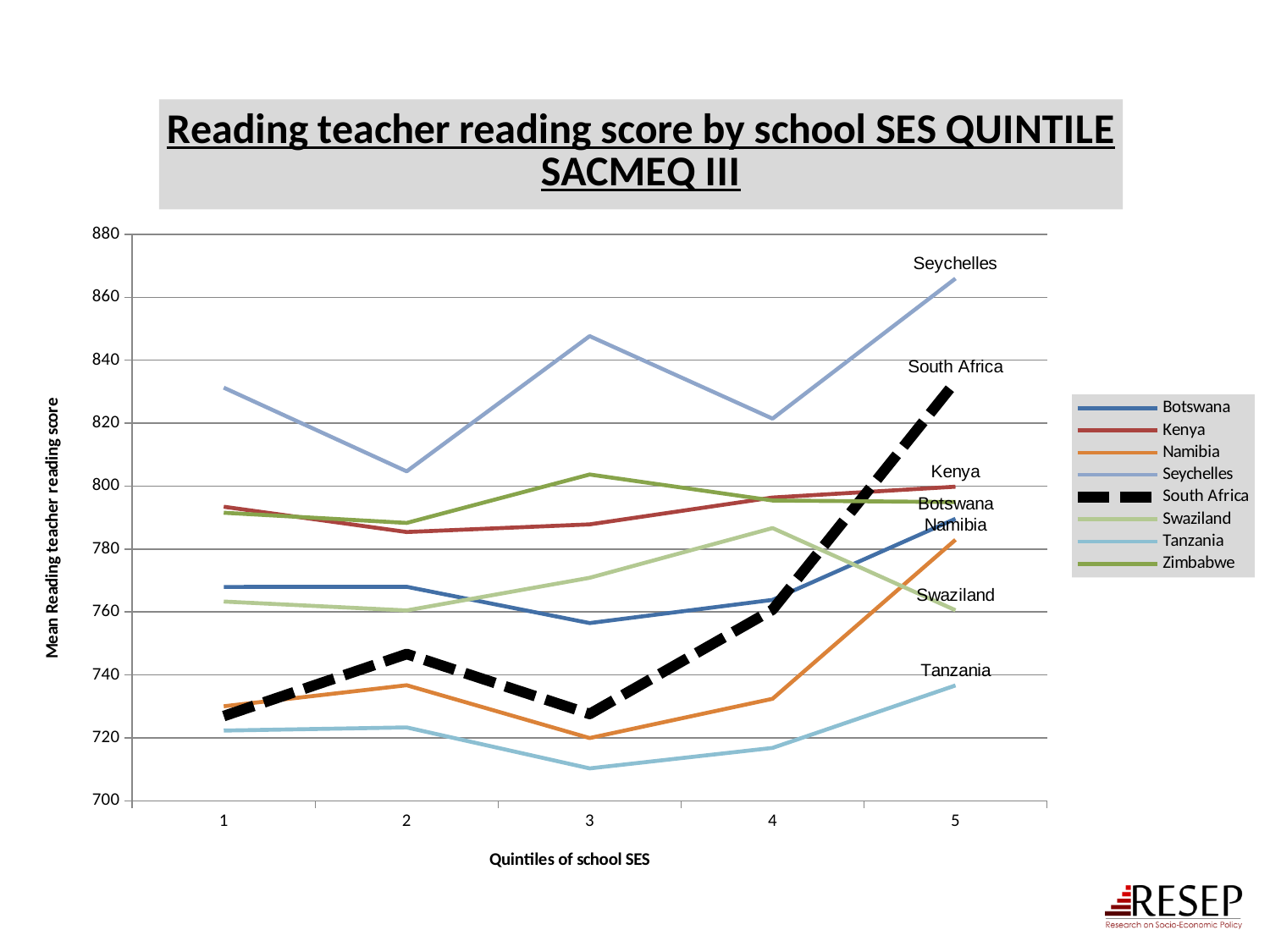
Is the value for Seychelles at quintile 5 greater or less than 840? greater Is the value for Tanzania at quintile 3 greater or less than 720? less How many school SES quintiles are shown on the x axis? 5 At quintile 1, which country has the higher score, Kenya or Botswana? Kenya Which country has the lowest mean reading teacher reading score at quintile 5? Tanzania How many countries are listed in the legend? 8 Which country's line is drawn as a thick dashed black line? South Africa Which country has the highest mean reading teacher reading score at quintile 1? Seychelles Is the value for South Africa at quintile 5 greater or less than 820? greater Does the South Africa line rise or fall from quintile 4 to quintile 5? rise What kind of chart is shown on the slide? line chart Which country has the highest mean reading teacher reading score at quintile 5? Seychelles